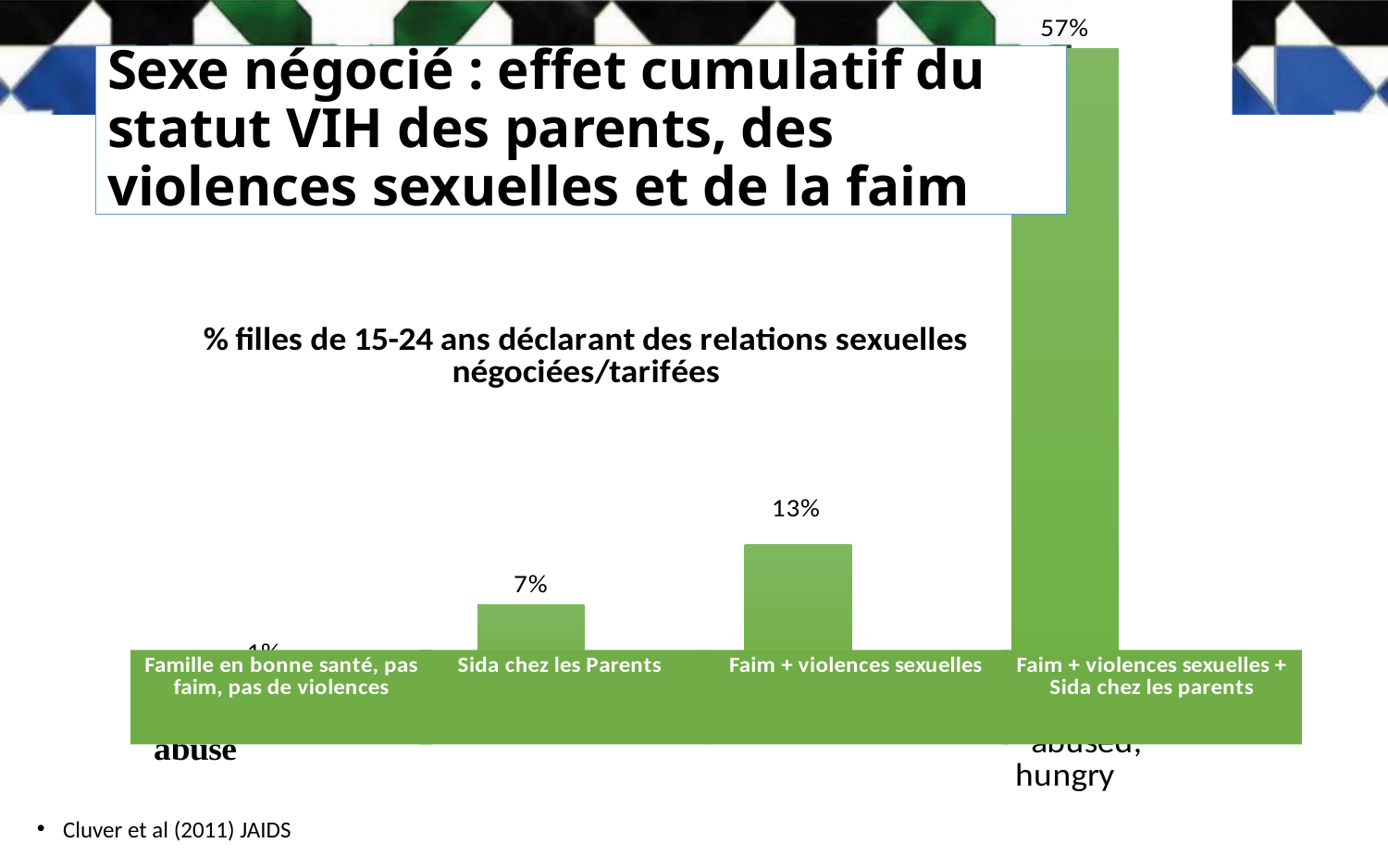
Which is larger, the value for "Sida chez les Parents" or the value for "Faim + violences sexuelles"? Faim + violences sexuelles What is the title of the chart? % filles de 15-24 ans déclarant des relations sexuelles négociées/tarifées What is the difference between the values for "Faim + violences sexuelles" and "Sida chez les Parents"? 6% What is the difference between the values for "Faim + violences sexuelles + Sida chez les parents" and "Faim + violences sexuelles"? 44% Which category has the lowest value? Famille en bonne santé, pas faim, pas de violences What is the value for "Sida chez les Parents"? 7% What is the value for "Faim + violences sexuelles + Sida chez les parents"? 57% What is the value for "Faim + violences sexuelles"? 13% What kind of chart is shown on the slide? Bar chart How many categories are shown in the chart? 4 Which category has the highest value? Faim + violences sexuelles + Sida chez les parents Do the values rise or fall from left to right across the categories? Rise